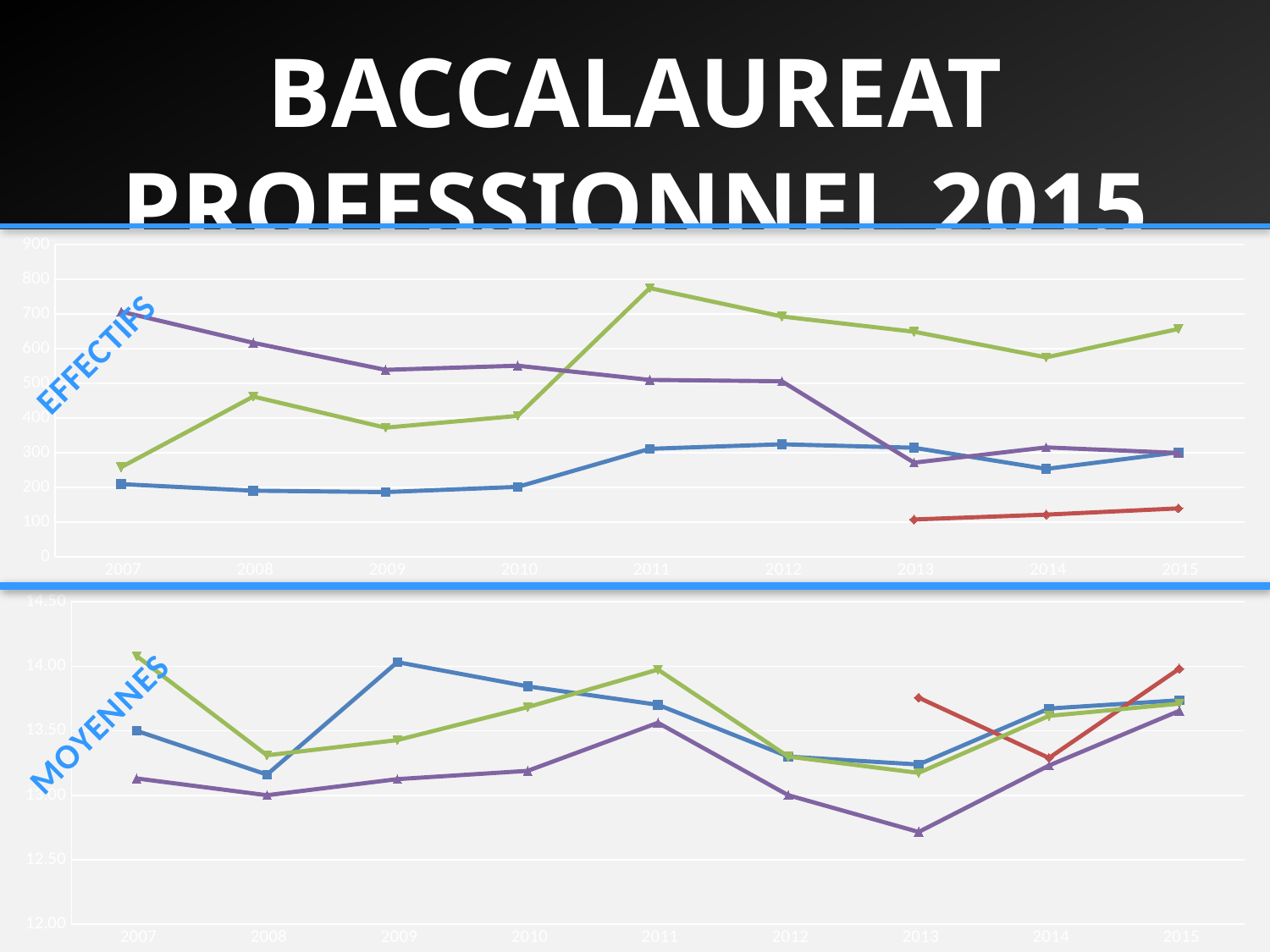
In the EFFECTIFS chart, does the red line rise or fall from 2013 to 2015? rise In the MOYENNES chart, is the value of the blue line in 2009 greater or less than 13.50? greater In the EFFECTIFS chart, is the value of the green line in 2011 greater or less than 700? greater In the EFFECTIFS chart, how many lines are plotted? 4 What kind of chart is the bottom chart labelled MOYENNES? line chart What kind of chart is the top chart labelled EFFECTIFS? line chart In the MOYENNES chart, how many years are shown on the x axis? 9 In the EFFECTIFS chart, in which year does the green line reach its highest value? 2011 In the EFFECTIFS chart, is the value of the red line in 2013 greater or less than 200? less In the EFFECTIFS chart, how many years are shown on the x axis? 9